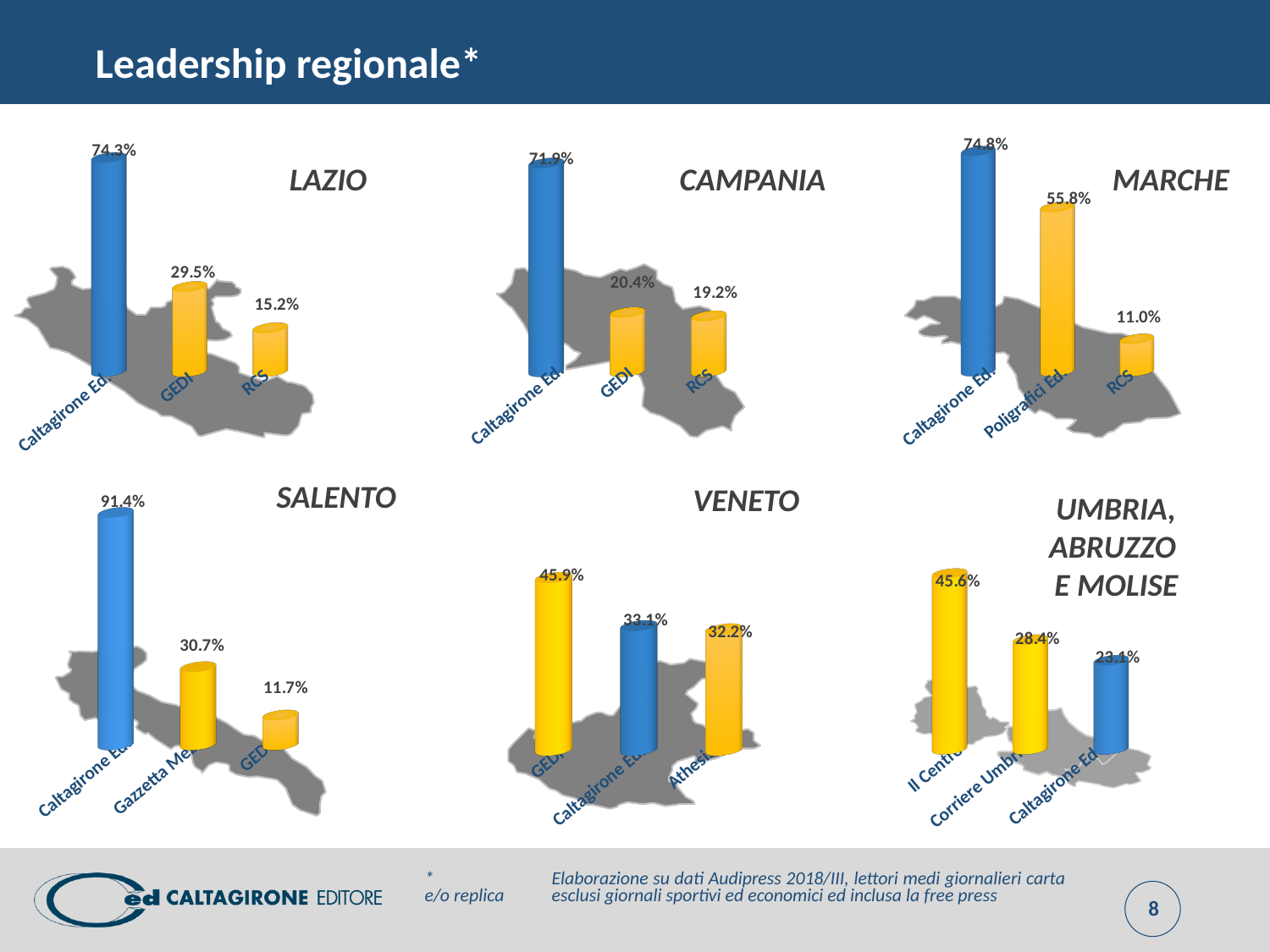
What kind of chart is the SALENTO chart? Bar chart In the MARCHE chart, which category has the lowest value? RCS In the LAZIO chart, what is the difference between the values for Caltagirone Ed. and GEDI? 44.8% In the MARCHE chart, what is the value for Poligrafici Ed.? 55.8% In the VENETO chart, which category has the highest value? GEDI How many charts are shown on the slide? 6 In the LAZIO chart, what is the value for RCS? 15.2% In the UMBRIA, ABRUZZO E MOLISE chart, which is larger: the value for Il Centro or the value for Caltagirone Ed.? Il Centro In the CAMPANIA chart, what is the value for GEDI? 20.4% How many categories are shown in the CAMPANIA chart? 3 In the SALENTO chart, which category has the highest value? Caltagirone Ed. In the LAZIO chart, what is the value for Caltagirone Ed.? 74.3%